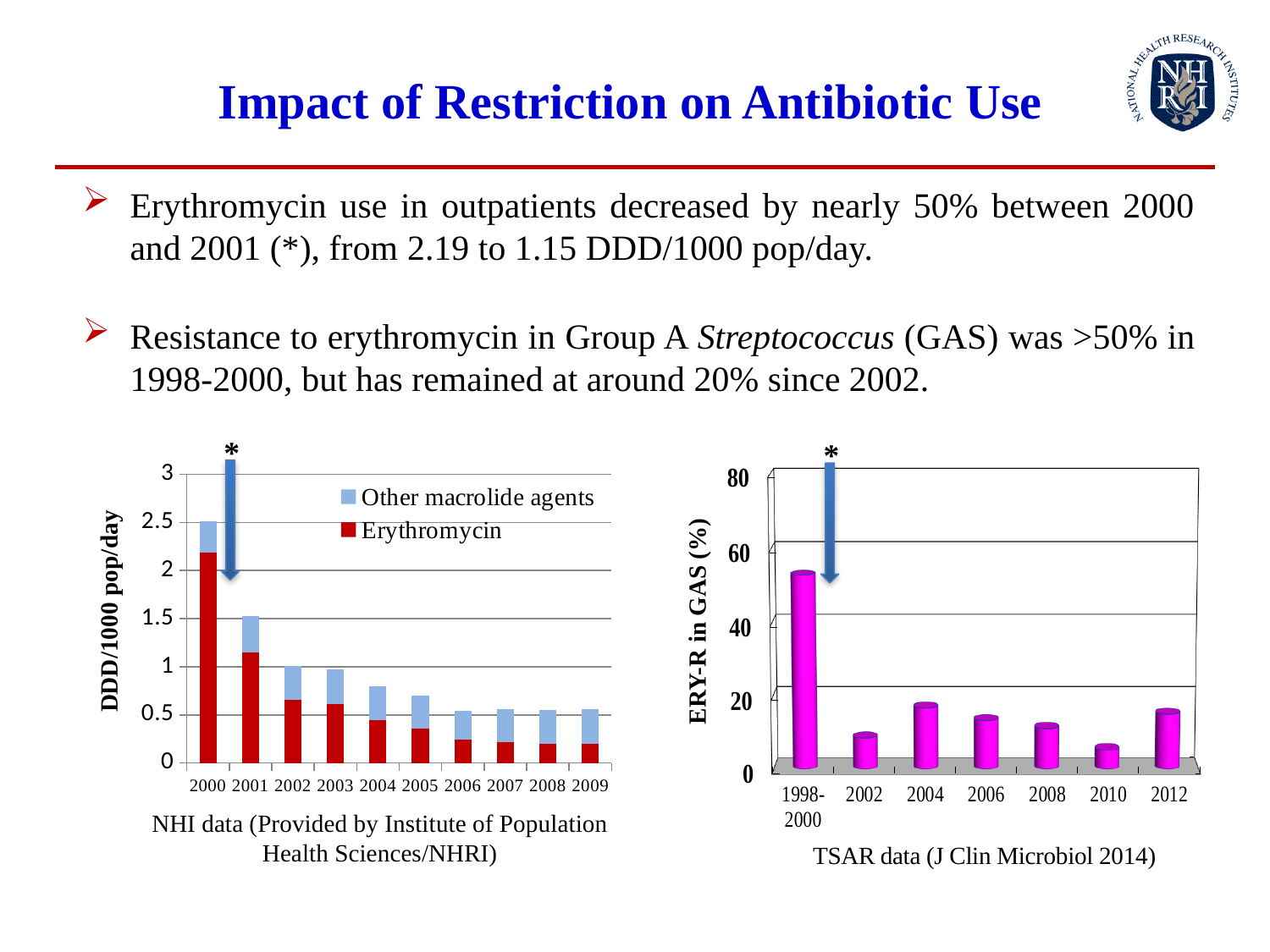
In the left chart (DDD/1000 pop/day), which year has the highest Erythromycin value? 2000 In the left chart (DDD/1000 pop/day), is the Erythromycin value for 2000 greater or less than 2? greater In the right chart (ERY-R in GAS), how many categories are shown on the x axis? 7 What kind of chart is the right chart (ERY-R in GAS)? bar chart In the left chart (DDD/1000 pop/day), how many series does the legend list? 2 In the left chart (DDD/1000 pop/day), do the Erythromycin values rise or fall from 2000 to 2009? fall In the right chart (ERY-R in GAS), which category has the lowest value? 2010 In the left chart (DDD/1000 pop/day), how many years are shown on the x axis? 10 In the left chart (DDD/1000 pop/day), what are the two series named in the legend? Other macrolide agents and Erythromycin In the right chart (ERY-R in GAS), is the value for 1998-2000 greater or less than 40? greater In the left chart (DDD/1000 pop/day), is the Erythromycin value for 2001 greater or less than 1? greater In the right chart (ERY-R in GAS), which category has the highest value? 1998-2000